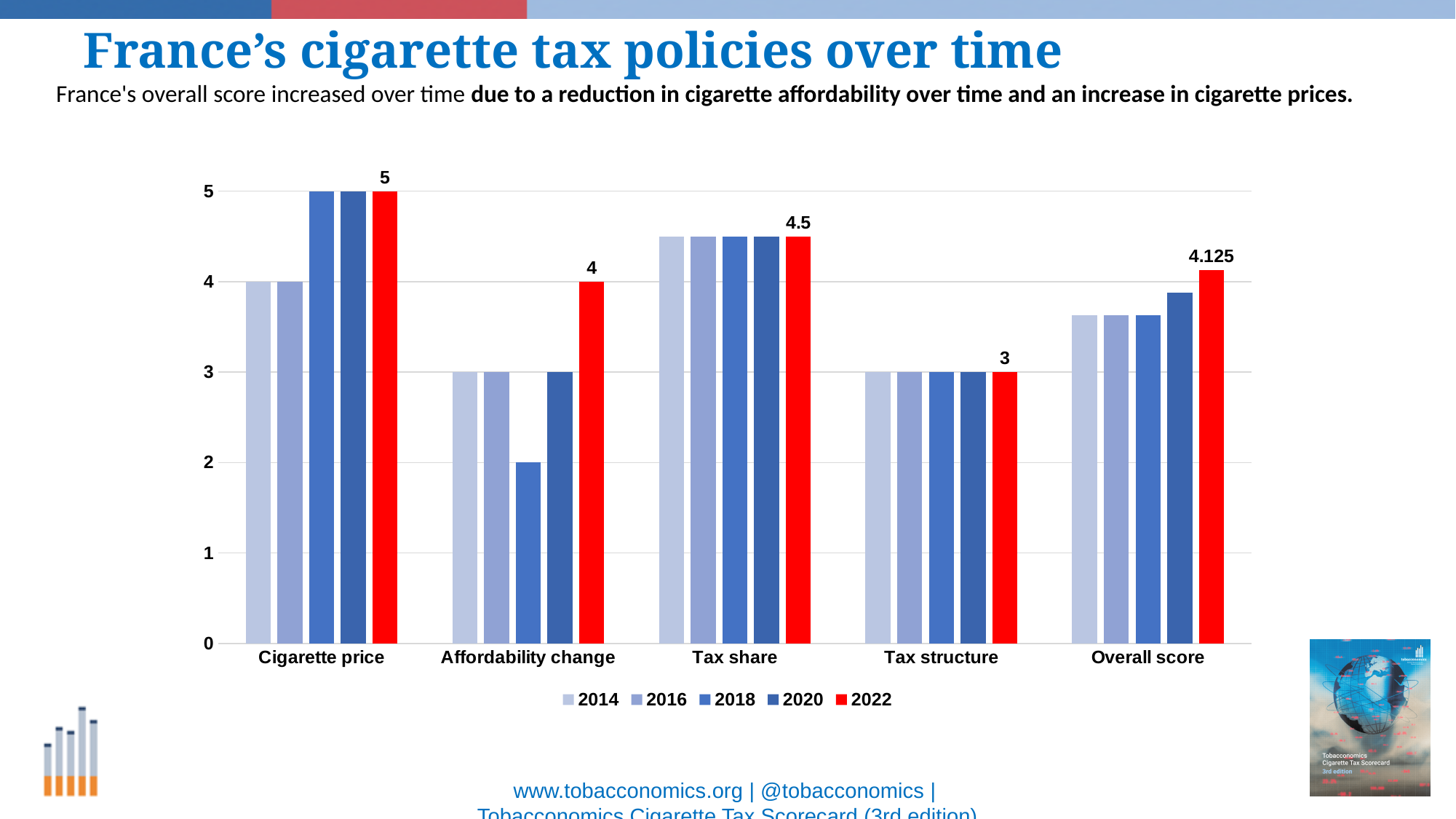
What is the 2022 value for Affordability change? 4 Is the 2020 value for Overall score greater or less than 4? less What is the 2022 value for Tax share? 4.5 What is the 2018 value for Affordability change? 2 How many categories are shown on the x axis? 5 What is the 2014 value for Cigarette price? 4 Which category has the highest 2022 value? Cigarette price What is the difference between the 2022 values for Cigarette price and Tax structure? 2 How many series does the legend list? 5 Which category has the lowest 2022 value? Tax structure What kind of chart is shown on the slide? Bar chart What is the 2022 value for Overall score? 4.125